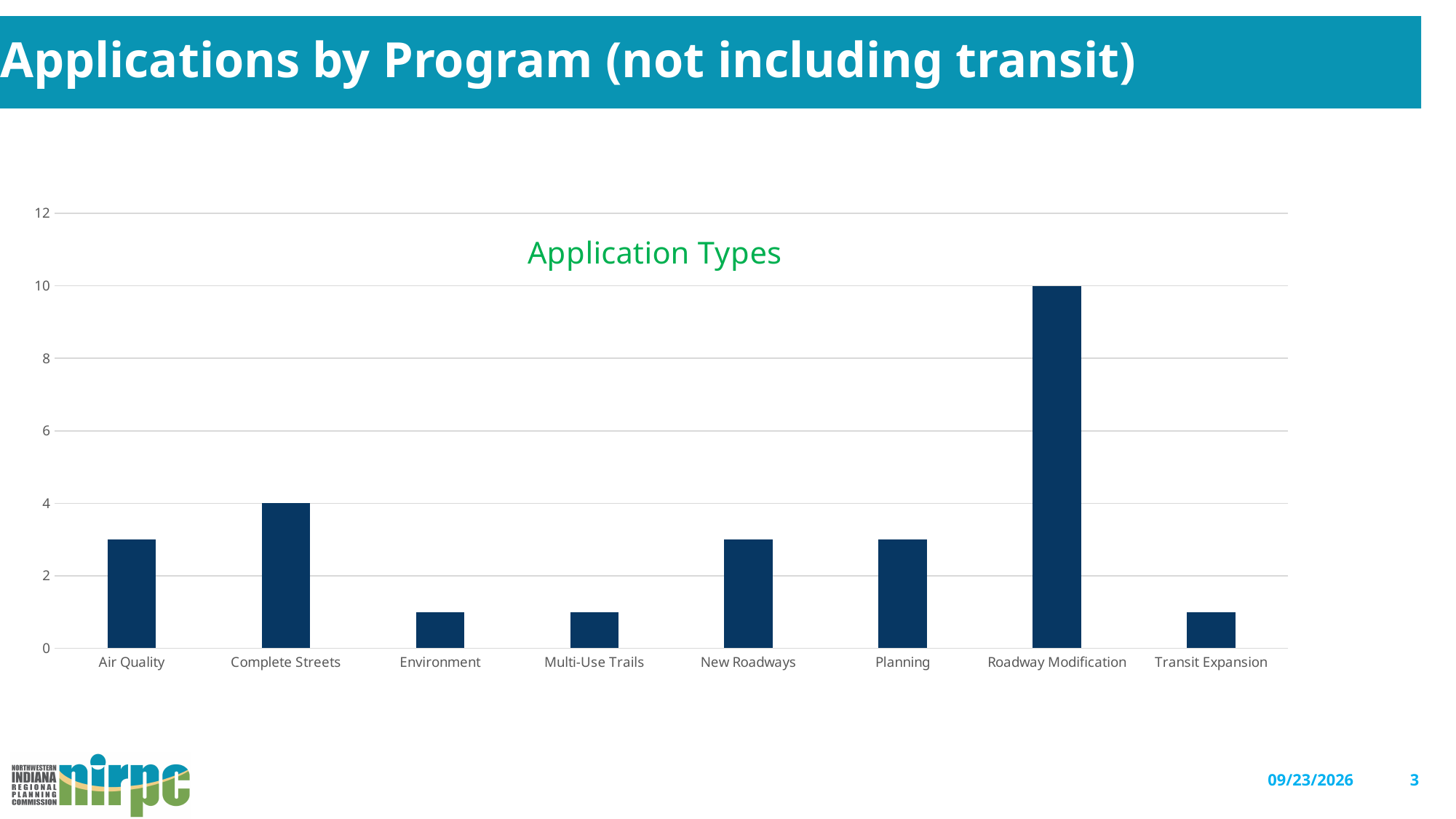
How many application type categories are shown on the x axis? 8 Is the value for Planning greater or less than 4? less How many applications are shown for Complete Streets? 4 What colour are the bars in the chart? Dark blue Which has more applications, Complete Streets or New Roadways? Complete Streets What type of chart is shown on the slide? Bar chart Is the value for Air Quality greater or less than 2? greater What is the difference between the number of applications for Roadway Modification and Complete Streets? 6 Is the value for Environment greater or less than 2? less How many applications are shown for Roadway Modification? 10 What is the title of the chart? Application Types Which application type has the highest number of applications? Roadway Modification